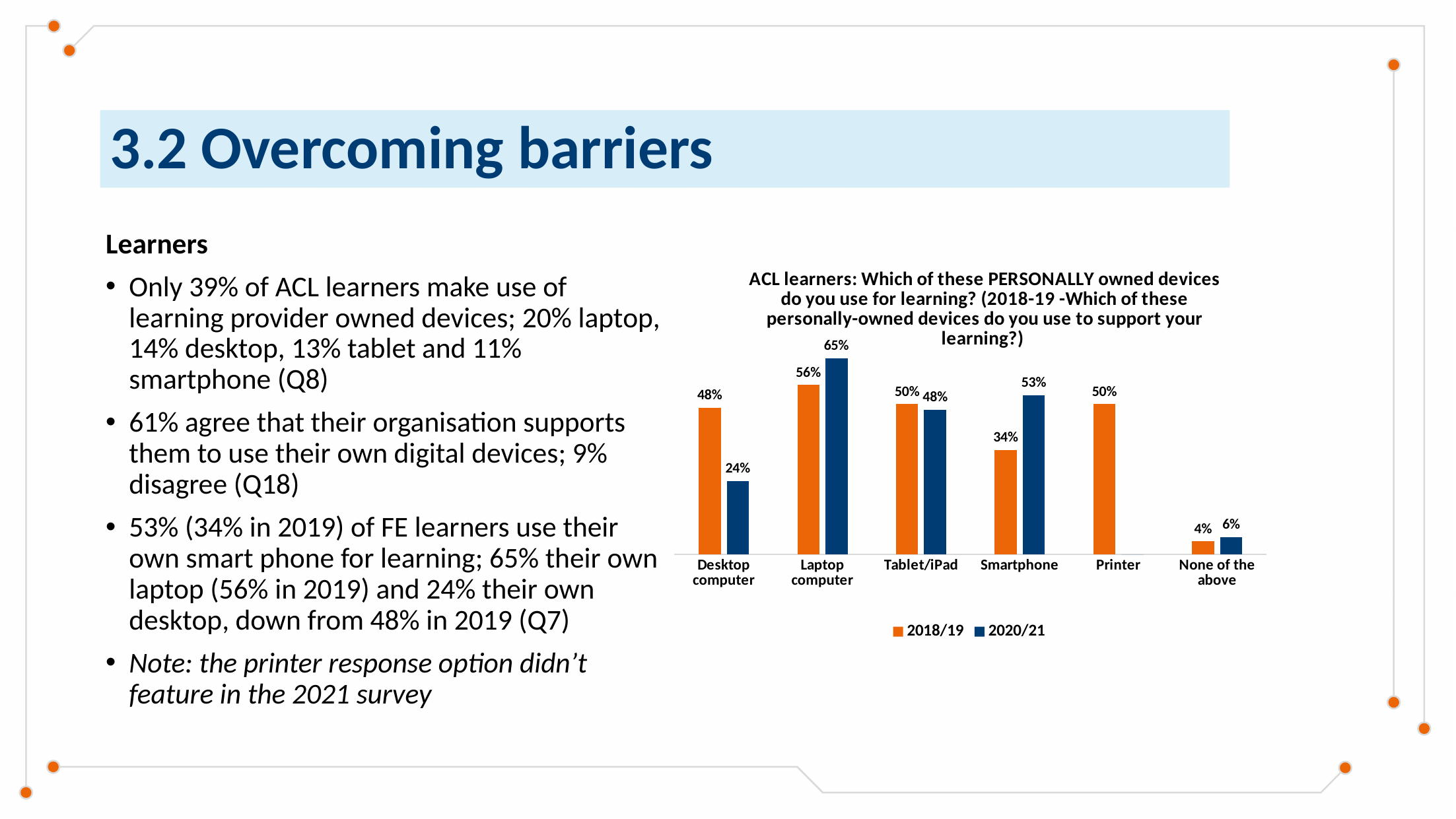
Which is larger for Smartphone: the 2018/19 value or the 2020/21 value? 2020/21 What is the 2018/19 value for Desktop computer? 48% Which category has the lowest 2018/19 value? None of the above What is the 2020/21 value for Laptop computer? 65% How many categories are shown on the x axis? 6 What is the 2020/21 value for Smartphone? 53% What kind of chart is shown on the slide? Bar chart What is the 2018/19 value for Printer? 50% How many series does the legend list? 2 Which category has the highest 2020/21 value? Laptop computer Which series is shown in orange in the legend? 2018/19 What is the difference between the 2018/19 and 2020/21 values for Desktop computer? 24%